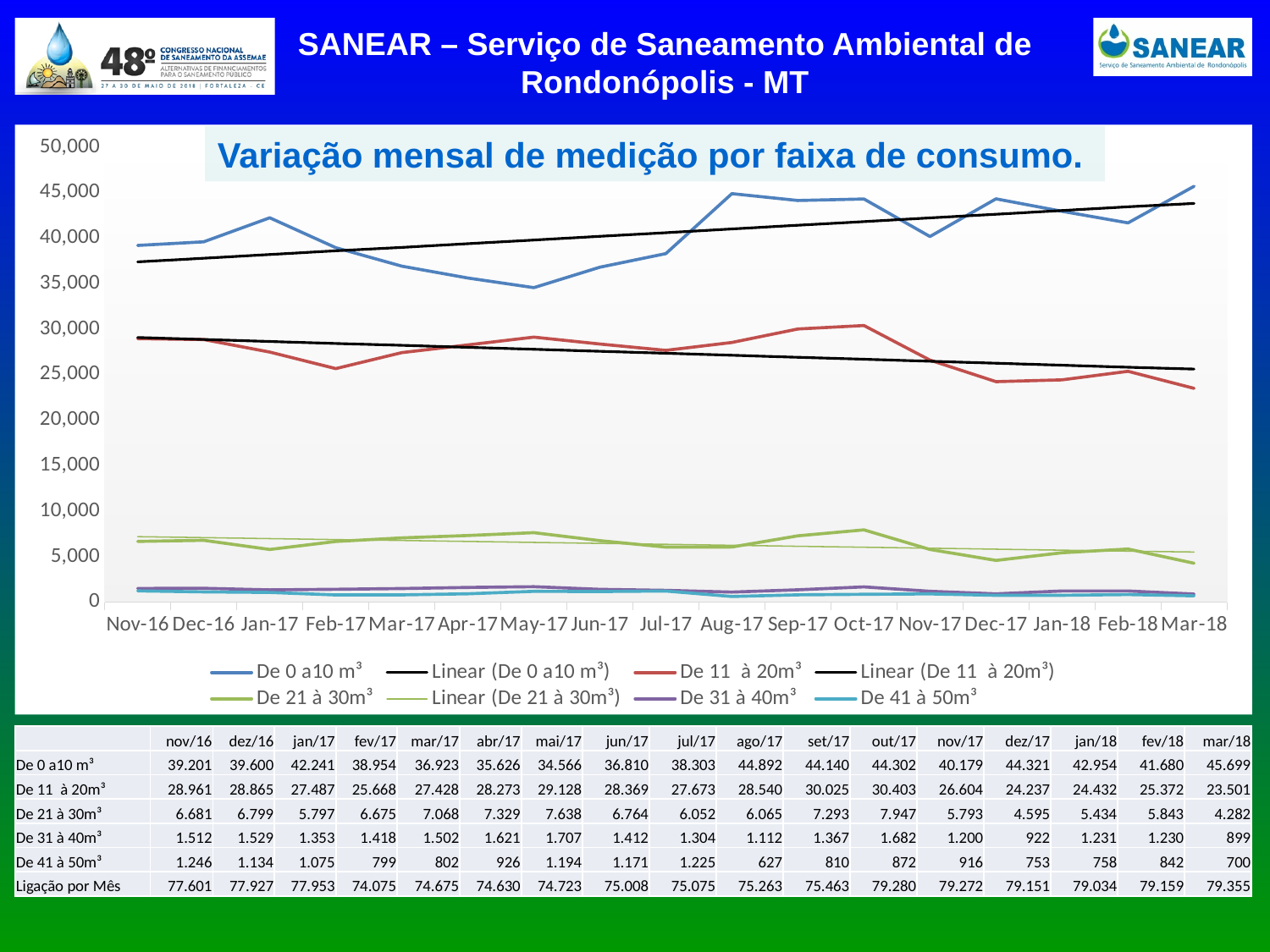
Is the value for 'De 0 a10 m³' in Aug-17 greater or less than 40,000? greater What is the value of the 'De 0 a10 m³' series in mar/18? 45.699 In which month does the 'De 0 a10 m³' series reach its lowest value? mai/17 Does the linear trend line for 'De 11 à 20m³' rise or fall from Nov-16 to Mar-18? Fall How many entries does the chart legend list? 8 What is the title of the chart? Variação mensal de medição por faixa de consumo. What is the difference between the 'De 0 a10 m³' value in mar/18 and in nov/16? 6.498 How many months are plotted along the x axis of the chart? 17 What is the value of the 'De 11 à 20m³' series in out/17? 30.403 Which is larger: the 'De 41 à 50m³' value in nov/16 or in ago/17? nov/16 In which month does the 'De 21 à 30m³' series reach its highest value? out/17 What type of chart is shown on the slide? Line chart